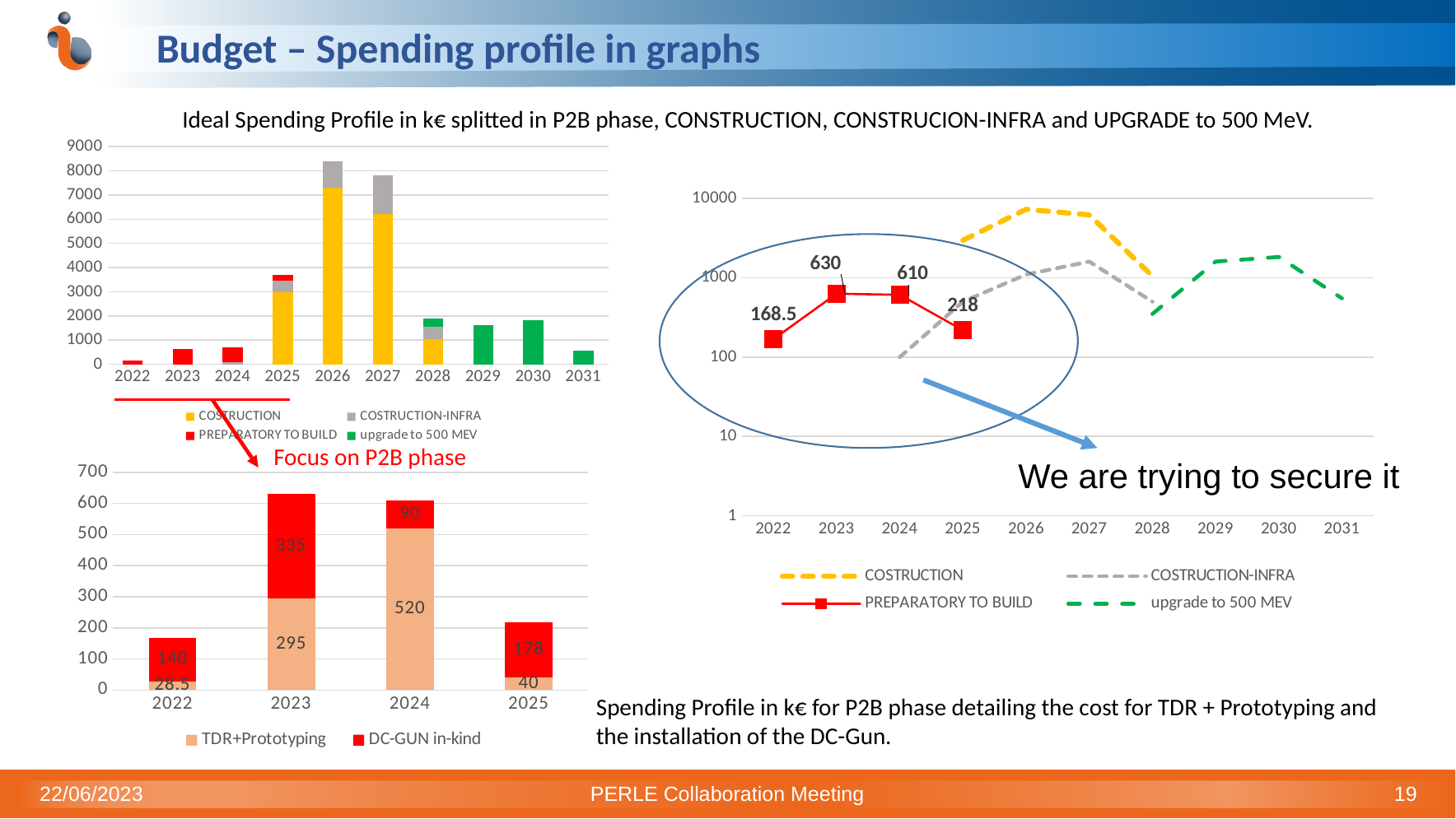
In the top-left chart (Ideal Spending Profile), which year has the tallest stacked bar? 2026 In the right-hand line chart, which year has the lowest labelled PREPARATORY TO BUILD value? 2022 In the top-left chart (Ideal Spending Profile), is the total value for 2027 greater or less than 7000? greater In the bottom-left chart (Focus on P2B phase), what is the difference between the TDR+Prototyping values for 2024 and 2023? 225 In the bottom-left chart (Focus on P2B phase), what is the DC-GUN in-kind value for 2023? 335 In the bottom-left chart (Focus on P2B phase), which year has the highest DC-GUN in-kind value? 2023 In the bottom-left chart (Focus on P2B phase), what is the total of the stacked bar for 2022? 168.5 In the bottom-left chart (Focus on P2B phase), how many series does the legend list? 2 In the right-hand line chart, how many series does the legend list? 4 In the right-hand line chart, what is the PREPARATORY TO BUILD value for 2023? 630 In the bottom-left chart (Focus on P2B phase), what is the TDR+Prototyping value for 2024? 520 In the bottom-left chart (Focus on P2B phase), what is the total of the stacked bar for 2025? 218